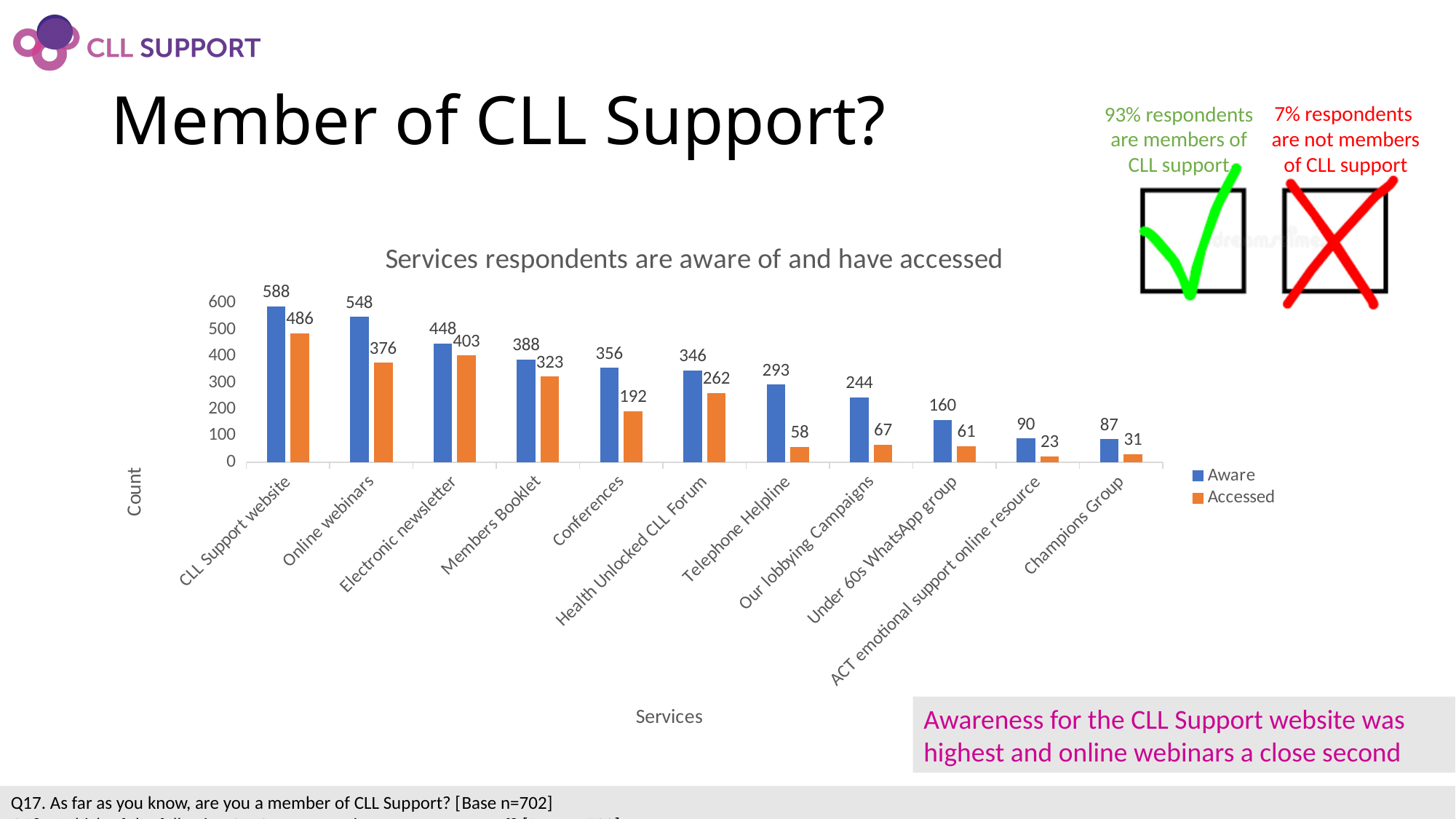
What kind of chart is shown? bar chart Which service has the highest Aware value? CLL Support website Do the Aware values rise or fall from left to right along the x axis? fall Which service has the lowest Accessed value? ACT emotional support online resource Which is larger: the Accessed value for Electronic newsletter or the Accessed value for Online webinars? Electronic newsletter What is the difference between the Aware and Accessed values for Members Booklet? 65 What is the Accessed value for Telephone Helpline? 58 What is the Aware value for Online webinars? 548 What is the Accessed value for Conferences? 192 How many services are shown on the x axis? 11 How many series does the legend list? 2 What is the title of the chart? Services respondents are aware of and have accessed